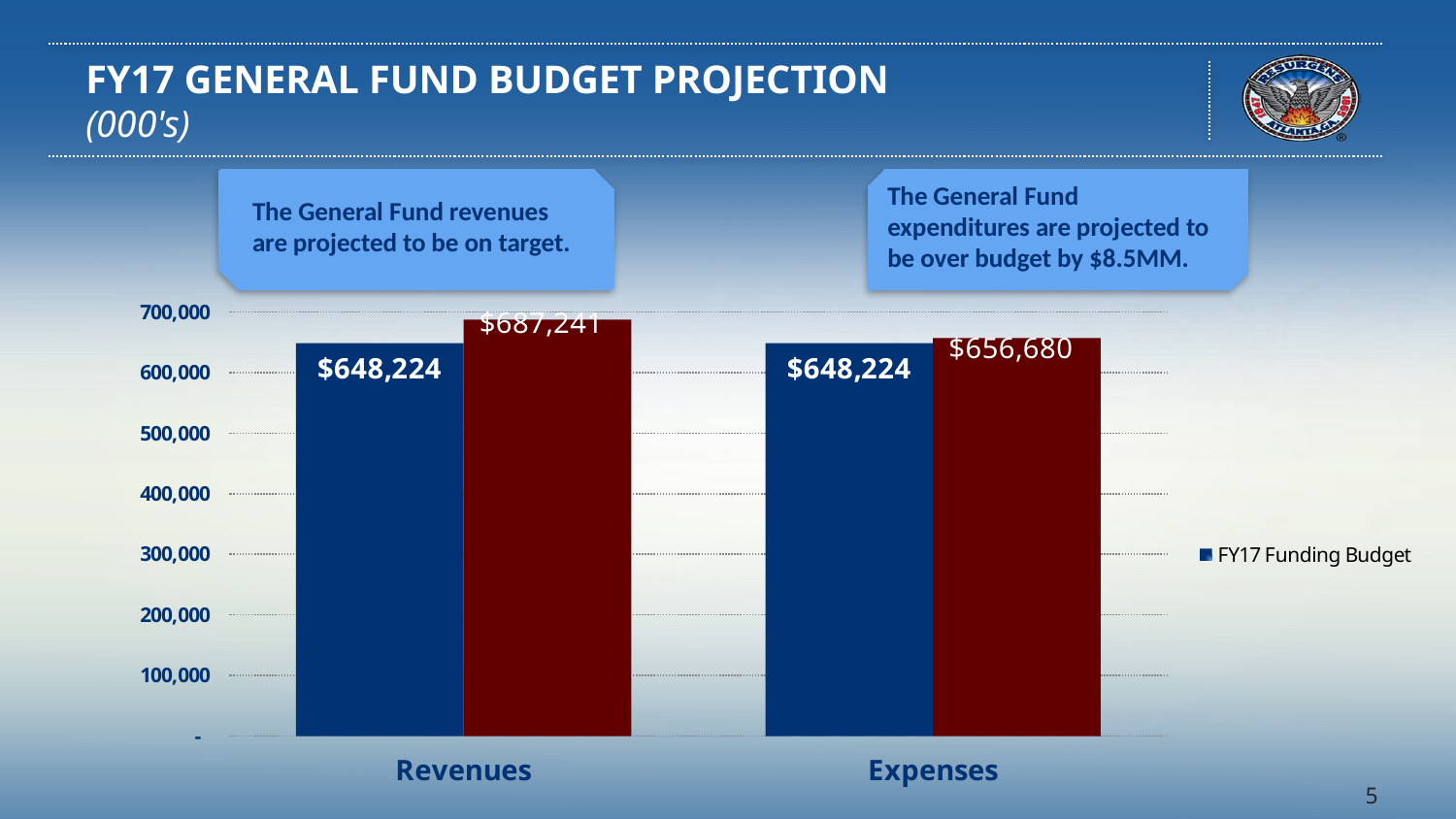
What is the FY17 Funding Budget value for Expenses? $648,224 What value is labelled on the dark red bar for Expenses? $656,680 What is the difference between the dark red bar and the FY17 Funding Budget bar for Revenues? $39,017 What value is labelled on the dark red bar for Revenues? $687,241 What is the highest value shown on the chart? $687,241 What is the FY17 Funding Budget value for Revenues? $648,224 How many categories are shown on the x axis? 2 What kind of chart is shown on the slide? Bar chart What is the difference between the dark red bar and the FY17 Funding Budget bar for Expenses? $8,456 What series name is listed in the chart legend? FY17 Funding Budget Which category has the larger dark red bar, Revenues or Expenses? Revenues Is the FY17 Funding Budget value for Revenues greater or less than 600,000? greater